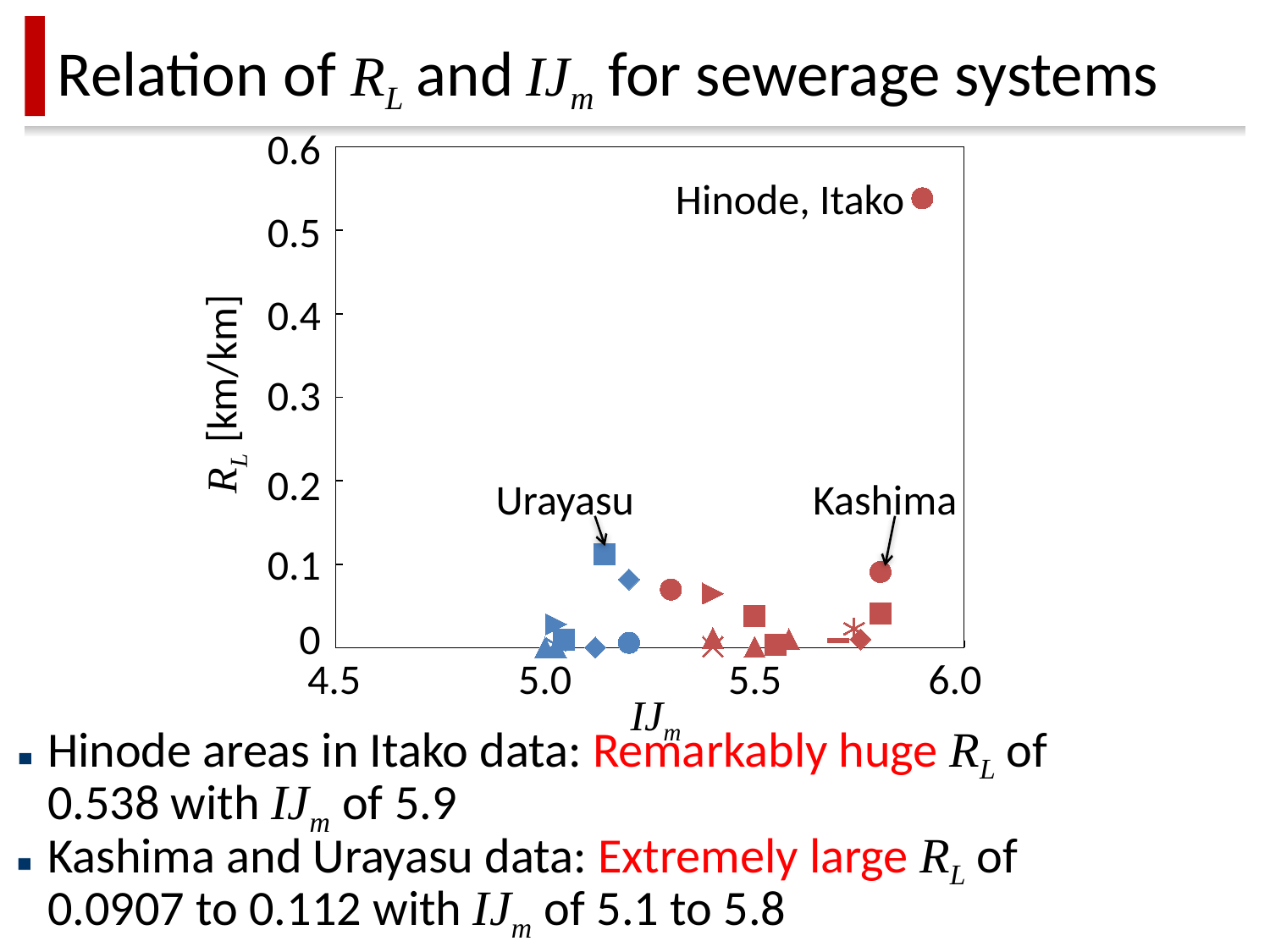
How many points on the chart are labelled with a place name? 3 Is the R_L value for Urayasu greater or less than 0.1? greater What is the R_L value for the Hinode area in Itako? 0.538 Which has the larger R_L value, Urayasu or Kashima? Urayasu Which has the larger IJ_m value, Kashima or Urayasu? Kashima What is the IJ_m value for the Hinode area in Itako? 5.9 Is the R_L value for Hinode, Itako greater or less than 0.5? greater Is the R_L value for Kashima greater or less than 0.1? less What kind of chart is shown on the slide? scatter chart Which labelled point has the highest R_L value? Hinode, Itako What is the label on the vertical axis of the chart? R_L [km/km] What is the range of the horizontal axis of the chart? 4.5 to 6.0